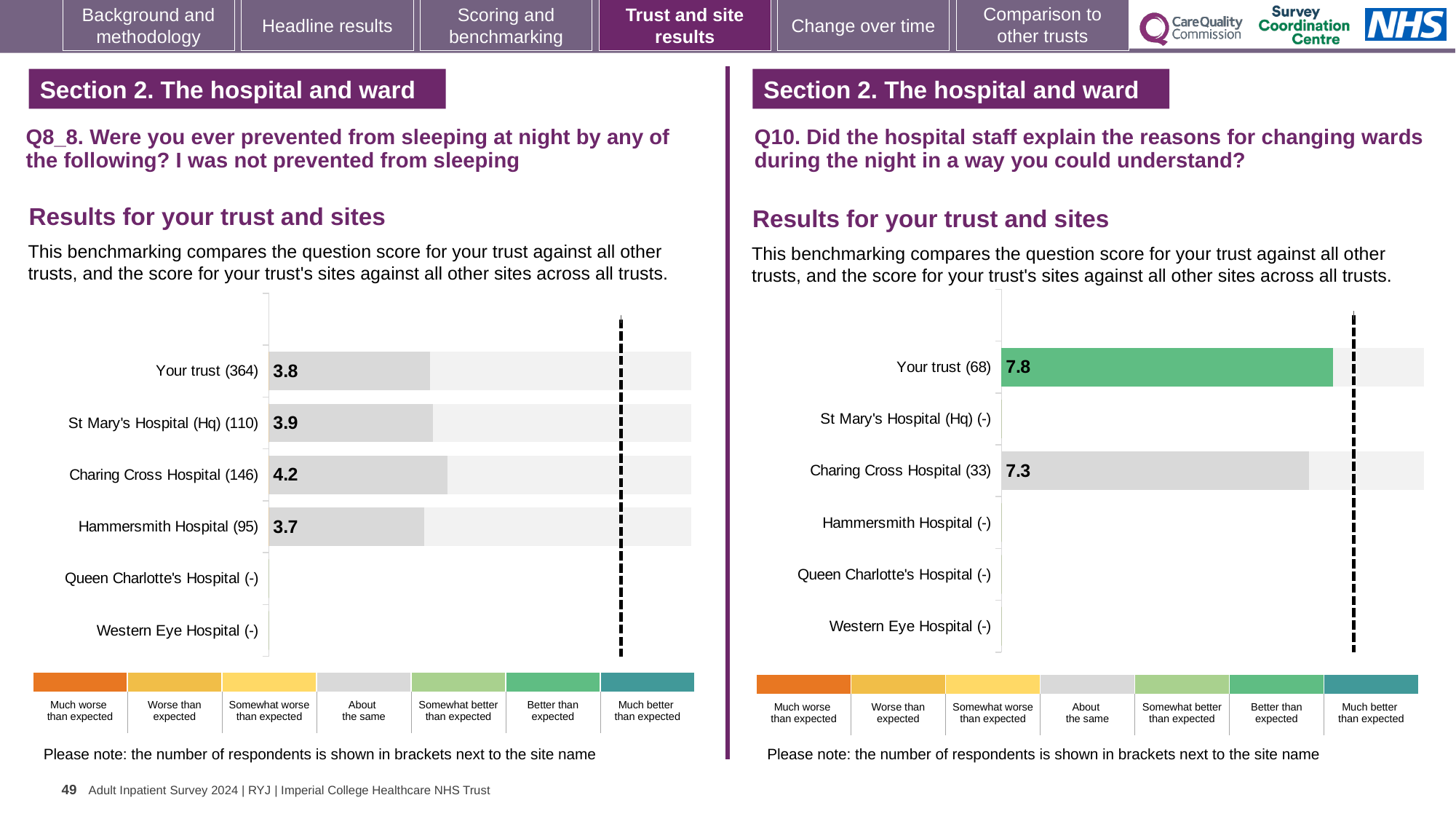
On the Q10 chart (right), how many sites have no score shown (marked with a dash)? 4 On the Q10 chart (right), what is the score for Charing Cross Hospital? 7.3 On the Q8_8 chart (left), what is the score for Your trust? 3.8 What type of chart is used on the Q8_8 chart (left)? Bar chart On the Q8_8 chart (left), what is the score for Charing Cross Hospital? 4.2 On the Q10 chart (right), what is the difference between the scores for Your trust and Charing Cross Hospital? 0.5 On the Q8_8 chart (left), how many respondents are shown for St Mary's Hospital (Hq)? 110 On the Q8_8 chart (left), which site has the highest score? Charing Cross Hospital On the Q10 chart (right), what is the score for Your trust? 7.8 On the Q8_8 chart (left), which site has the lowest score among those with a value shown? Hammersmith Hospital On the Q8_8 chart (left), what is the difference between the scores for Charing Cross Hospital and Hammersmith Hospital? 0.5 On the Q10 chart (right), which is larger, the score for Your trust or for Charing Cross Hospital? Your trust